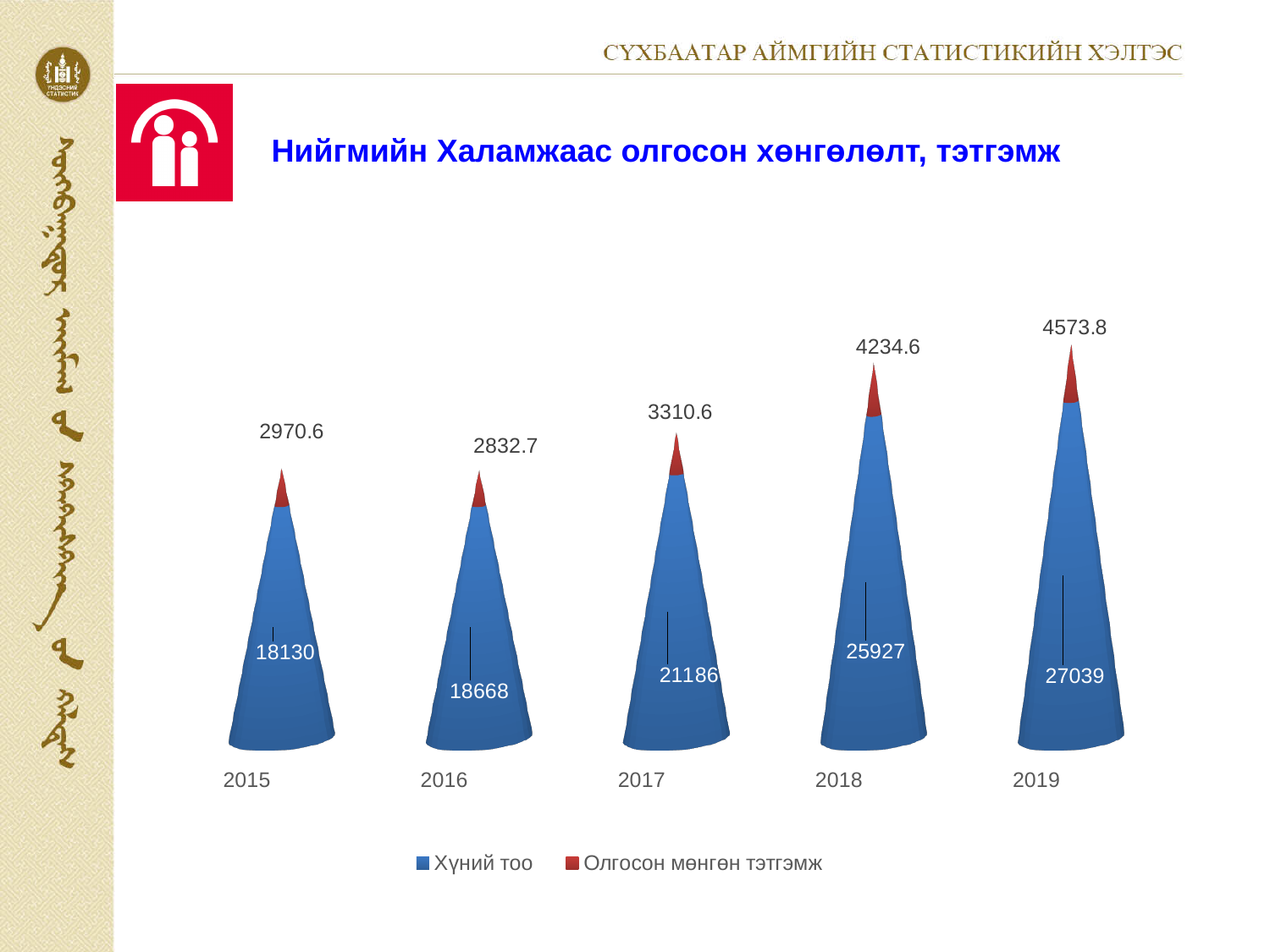
What kind of chart is shown on the slide? Stacked bar chart How many years are shown on the x axis? 5 What is the value of Хүний тоо for 2019? 27039 Does the value of Хүний тоо rise or fall from 2016 to 2019? Rise What is the value of Хүний тоо for 2015? 18130 What is the difference in Хүний тоо between 2018 and 2017? 4741 Which is larger, Олгосон мөнгөн тэтгэмж in 2015 or in 2016? 2015 Which year has the lowest value for Олгосон мөнгөн тэтгэмж? 2016 How many series does the legend list? 2 What is the value of Олгосон мөнгөн тэтгэмж for 2017? 3310.6 Which year has the highest value for Хүний тоо? 2019 What is the value of Олгосон мөнгөн тэтгэмж for 2016? 2832.7